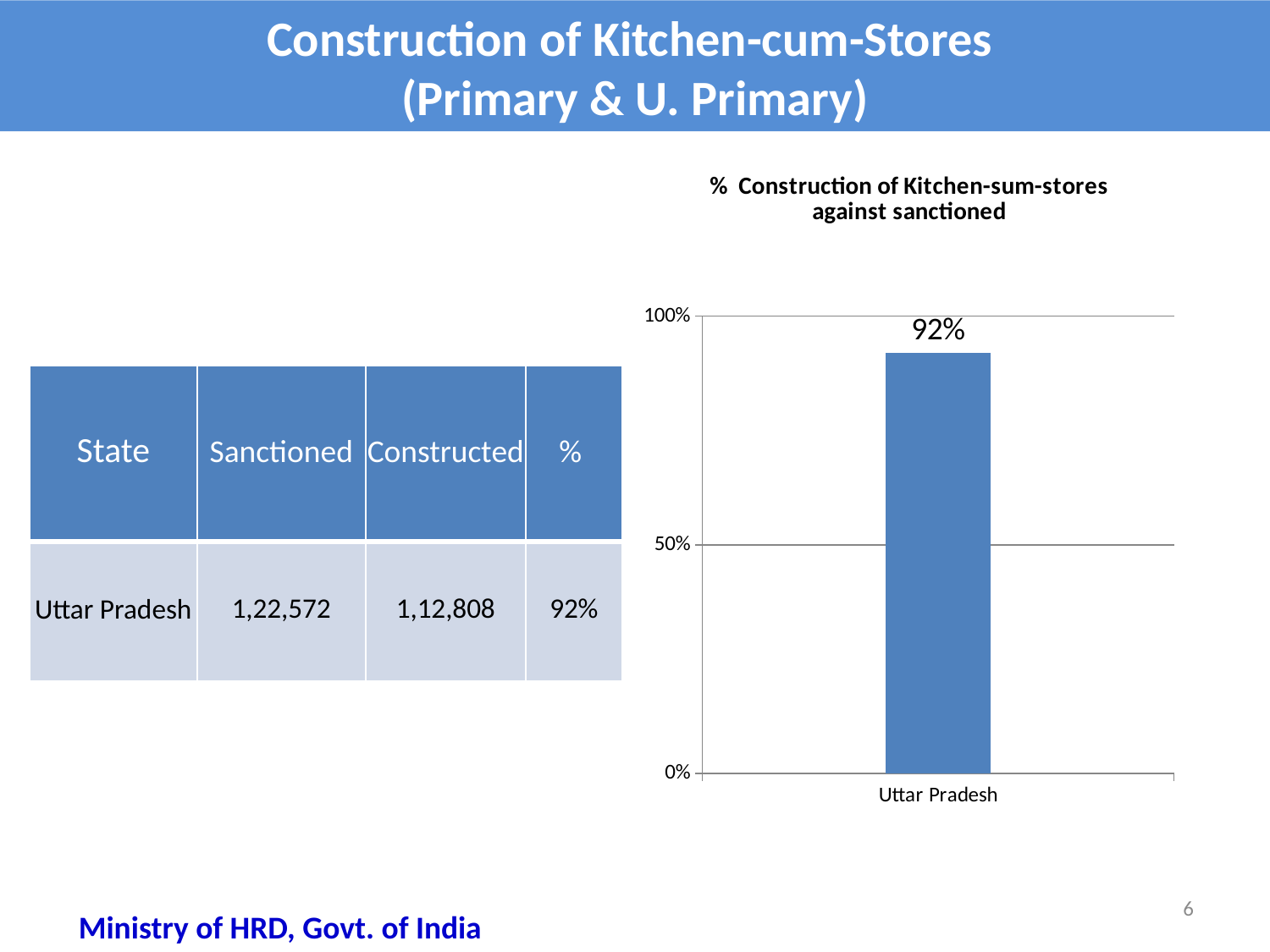
Is the value for Uttar Pradesh greater or less than 50%? greater Is the value for Uttar Pradesh greater or less than 100%? less How many categories are plotted on the x axis of the chart? 1 What kind of chart is shown on the slide? bar chart What is the value shown for Uttar Pradesh in the chart? 92% Which state is shown on the x axis of the chart? Uttar Pradesh What is the title of the chart? % Construction of Kitchen-sum-stores against sanctioned What is the highest value shown on the y axis of the chart? 100%